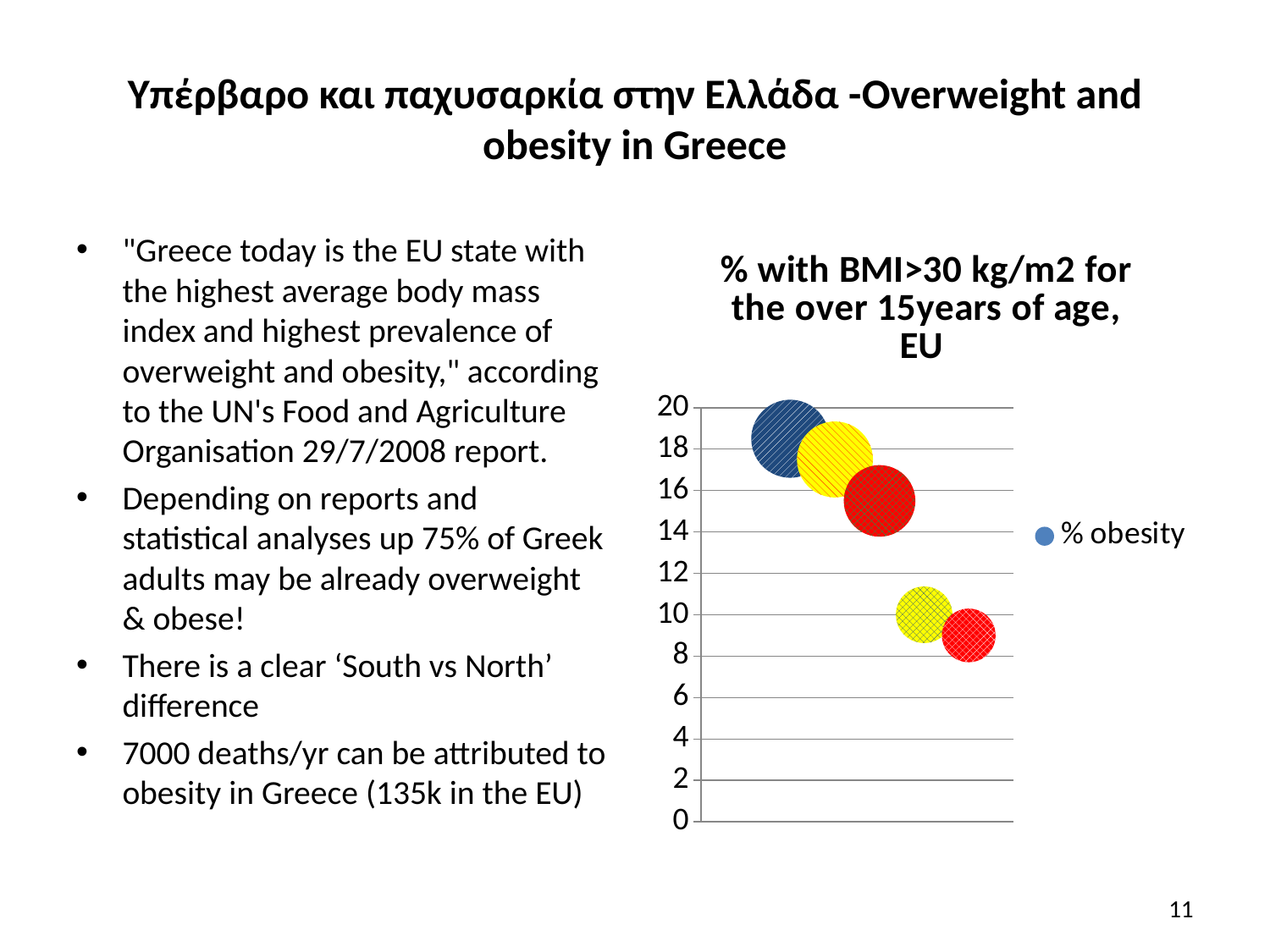
How many series does the chart legend list? 1 Is the value of the blue bubble greater or less than 16? greater Is the value of the small red bubble on the far right greater or less than 10? less Which bubble has the highest value: the blue one on the left or the small red one on the right? the blue one on the left How many bubbles are plotted in the chart? 5 Is the value of the small yellow bubble greater or less than 14? less Do the bubble values rise or fall from left to right across the chart? fall What kind of chart is shown on the slide? bubble chart What is the maximum value shown on the vertical axis? 20 What is the title of the chart? % with BMI>30 kg/m2 for the over 15years of age, EU What is the legend entry of the chart? % obesity